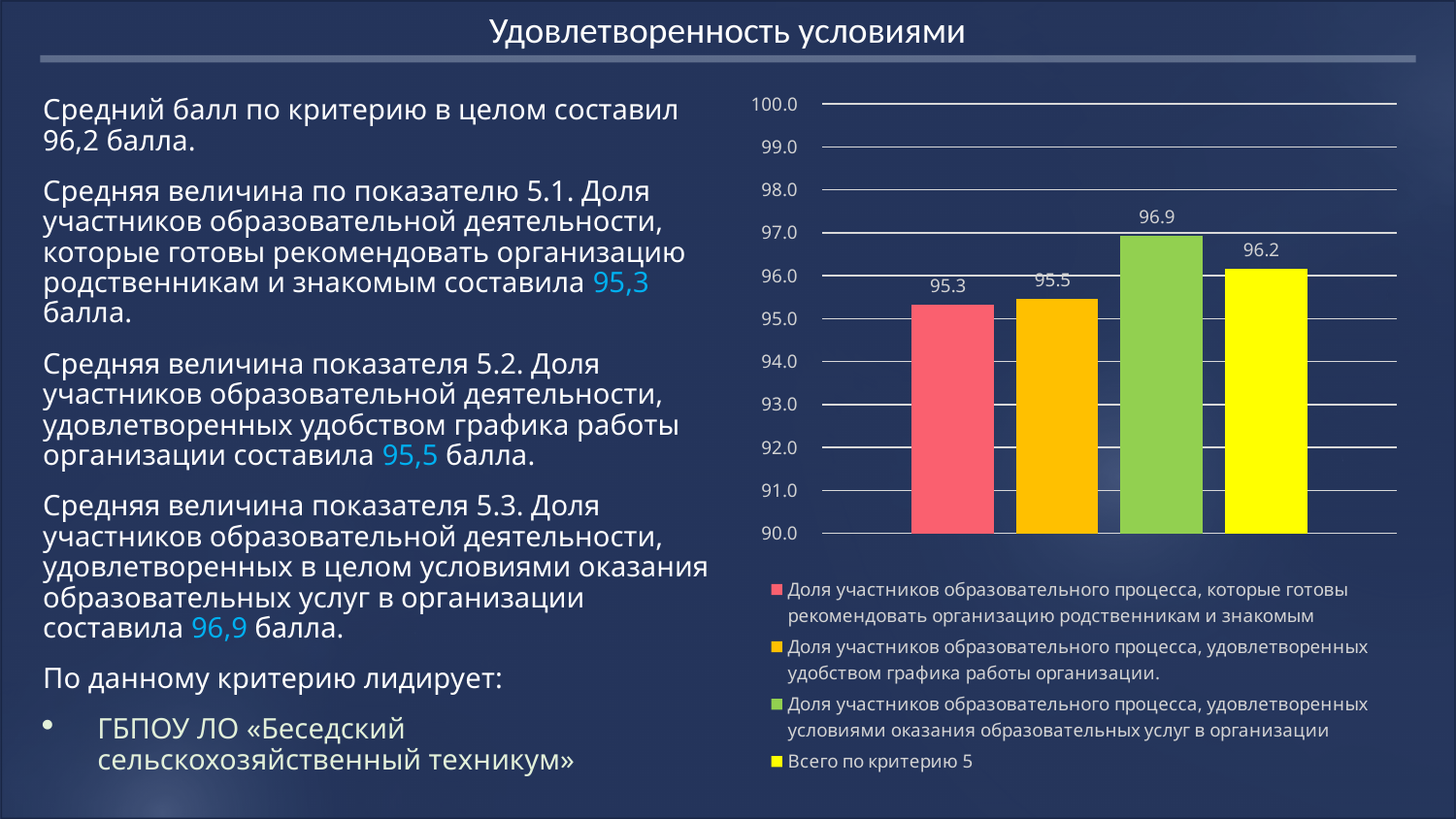
What value is shown for the bar 'Всего по критерию 5'? 96.2 What is the difference between the highest bar (96.9) and the lowest bar (95.3)? 1.6 What type of chart is shown on the slide? Bar chart Which is larger: the value for satisfaction with the working schedule or the value for readiness to recommend the organisation? Satisfaction with the working schedule (95.5) What value is shown for the share of participants ready to recommend the organisation to relatives and acquaintances? 95.3 How many series does the legend list? 4 Which series has the highest value in the chart? Доля участников образовательного процесса, удовлетворенных условиями оказания образовательных услуг в организации What value is shown for the share of participants satisfied with the convenience of the organisation's working schedule? 95.5 What value is shown for the share of participants satisfied with the conditions of providing educational services? 96.9 Is the value for 'Всего по критерию 5' greater or less than 96.0? greater How many bars are plotted in the chart? 4 Which series has the lowest value in the chart? Доля участников образовательного процесса, которые готовы рекомендовать организацию родственникам и знакомым